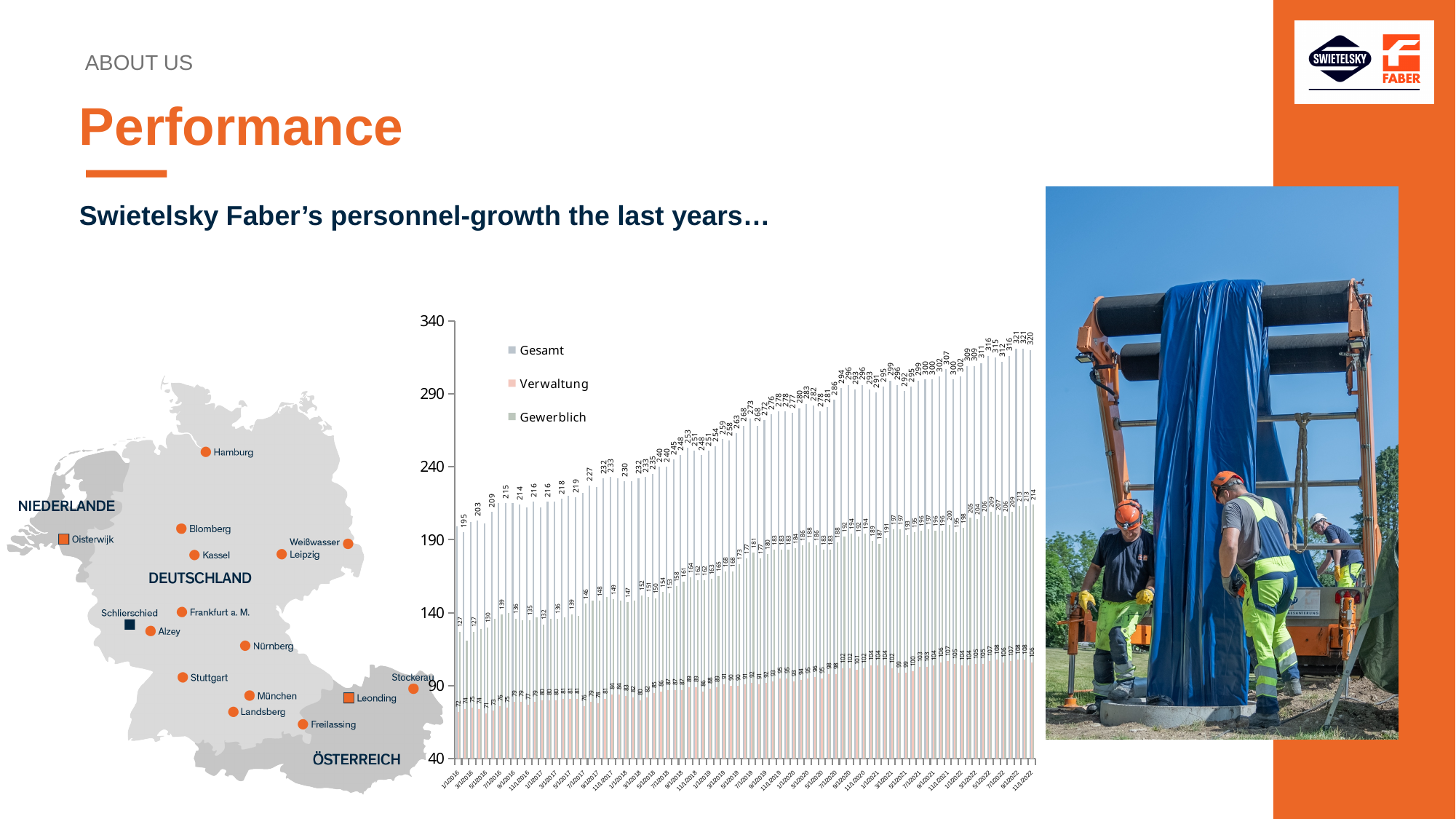
What is the Gewerblich value for the last month shown (11/2022)? 214 What is the Gesamt value for the last month shown (11/2022)? 320 What is the subtitle describing the chart on the slide? Swietelsky Faber's personnel-growth the last years… What is the Gewerblich value for the first month shown (1/2016)? 127 What kind of chart is shown on the slide? bar chart How many series does the chart legend list? 3 What are the three series named in the chart legend? Gesamt, Verwaltung, Gewerblich What is the Verwaltung value for the last month shown (11/2022)? 106 Does the Gesamt series generally rise or fall from 2016 to 2022? rise Is the Verwaltung value for the last month shown (11/2022) greater or less than 90? greater